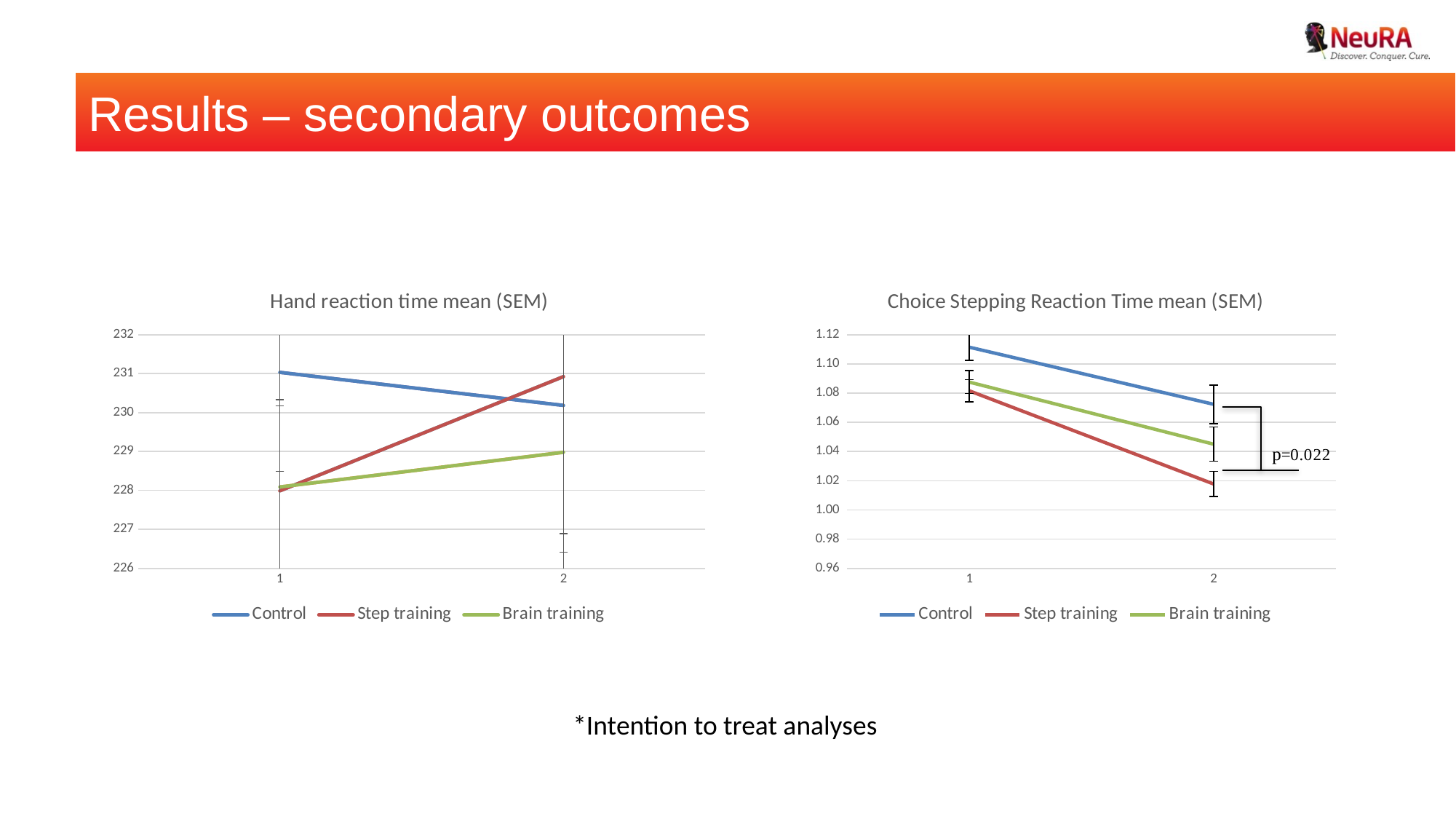
What p-value is annotated on the 'Choice Stepping Reaction Time mean (SEM)' chart? p=0.022 In the 'Choice Stepping Reaction Time mean (SEM)' chart, which series has the lowest value at point 2? Step training What kind of chart is the 'Hand reaction time mean (SEM)' chart? line chart In the 'Choice Stepping Reaction Time mean (SEM)' chart, does the Step training line rise or fall from point 1 to point 2? fall In the 'Hand reaction time mean (SEM)' chart, does the Control line rise or fall from point 1 to point 2? fall How many points are on the x axis of the 'Hand reaction time mean (SEM)' chart? 2 How many series does the legend of the 'Choice Stepping Reaction Time mean (SEM)' chart list? 3 In the 'Hand reaction time mean (SEM)' chart, is the value for Brain training at point 2 greater or less than 230? less In the 'Choice Stepping Reaction Time mean (SEM)' chart, is the value for Control at point 1 greater or less than 1.10? greater In the 'Hand reaction time mean (SEM)' chart, is the value for Control at point 1 greater or less than 230? greater In the 'Hand reaction time mean (SEM)' chart, does the Step training line rise or fall from point 1 to point 2? rise In the 'Hand reaction time mean (SEM)' chart, which series has the highest value at point 2? Step training